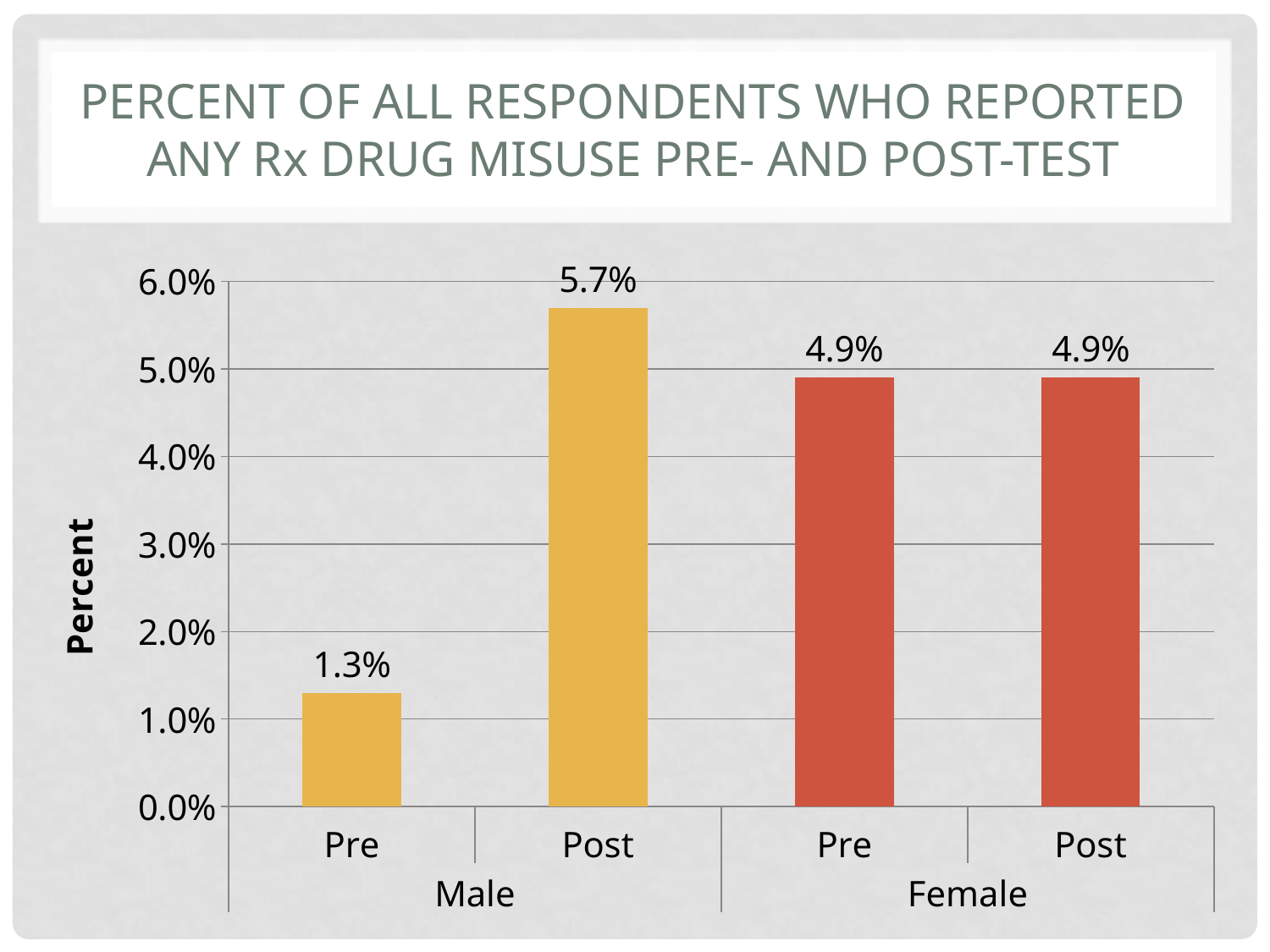
What is the value for Male Pre? 1.3% Which bar has the highest value? Male Post What is the value for Female Pre? 4.9% Which bar has the lowest value? Male Pre What is the value for Male Post? 5.7% What is the difference between the Male Post and Male Pre values? 4.4% How many bars are plotted in the chart? 4 What is the value for Female Post? 4.9% Is the value for Male Pre greater or less than 2.0%? less What kind of chart is shown on the slide? bar chart Which is larger, the Male Post value or the Female Post value? Male Post What is the label on the vertical axis? Percent